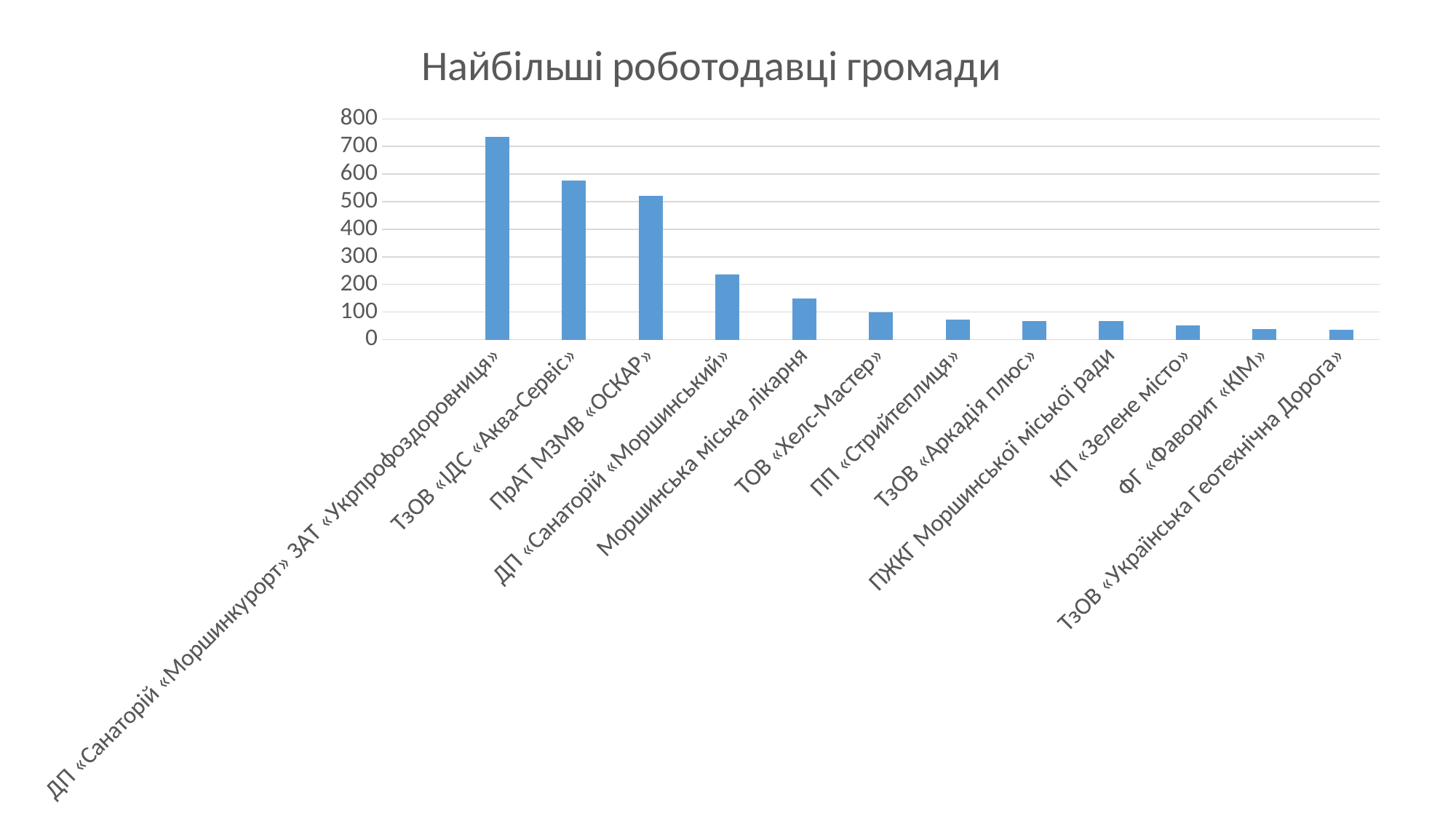
Which employer has the highest value in the chart? ДП «Санаторій «Моршинкурорт» ЗАТ «Укрпрофоздоровниця» Is the value for ДП «Санаторій «Моршинський» greater or less than 300? less Is the value for ТзОВ «ІДС «Аква-Сервіс» greater or less than 500? greater Is the value for ПП «Стрийтеплиця» greater or less than 100? less Do the values rise or fall from left to right along the x axis? fall How many employers (categories) are shown in the chart? 12 Which is larger, the value for ТзОВ «ІДС «Аква-Сервіс» or the value for ПрАТ МЗМВ «ОСКАР»? ТзОВ «ІДС «Аква-Сервіс» What type of chart is shown on the slide? bar chart What is the title of the chart? Найбільші роботодавці громади